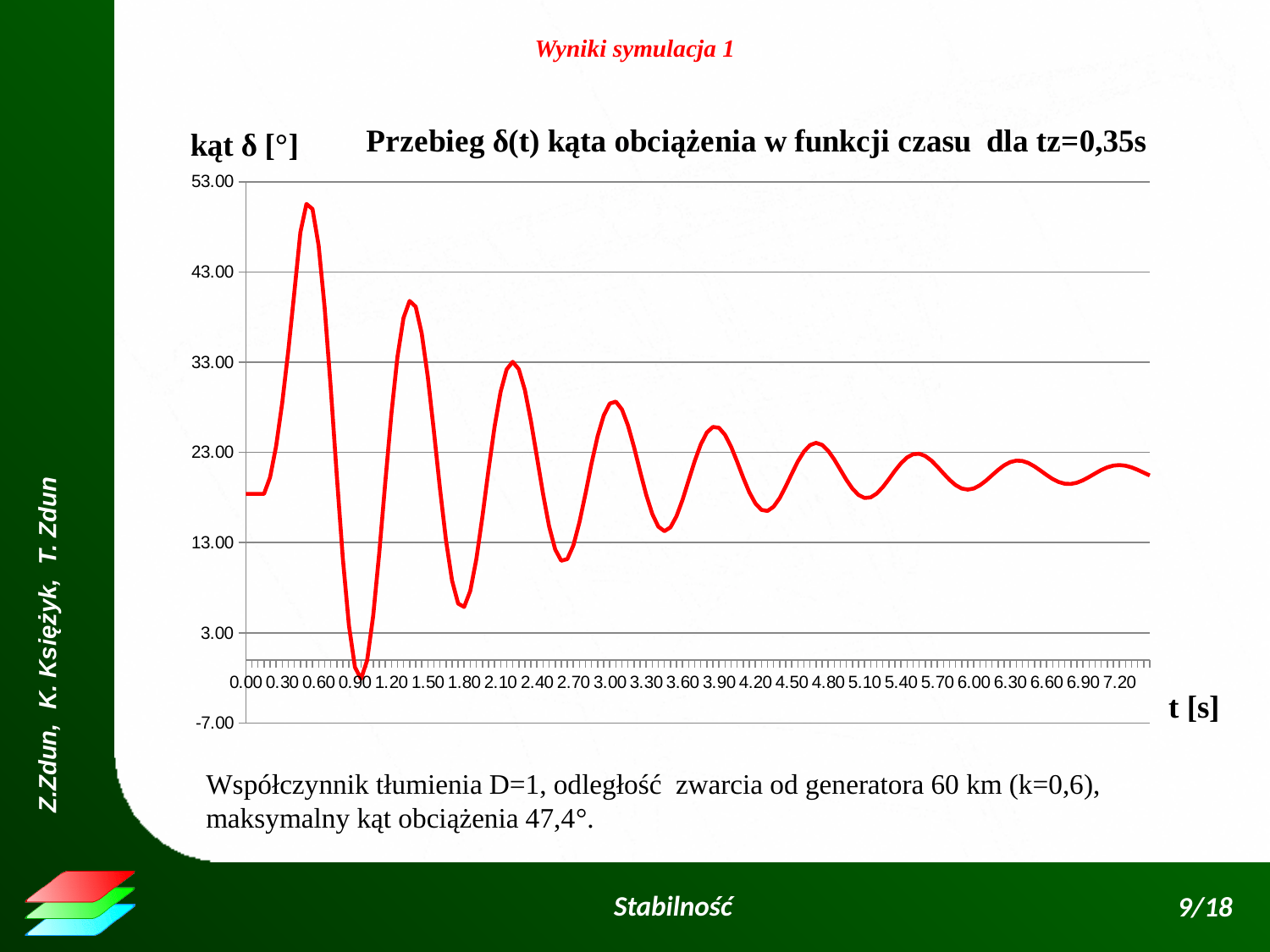
Is the second peak of the curve (near t=1.40) greater or less than 33.00? greater What is the highest value shown on the vertical axis of the chart? 53.00 What kind of chart is shown on the slide? line chart Does the amplitude of the oscillations increase or decrease as time increases along the x axis? decrease What label is shown on the horizontal axis of the chart? t [s] Is the lowest point of the curve (near t=0.90) greater or less than 3.00? less Is the value of δ at t=0.00 greater or less than 13.00? greater What is the title of the chart? Przebieg δ(t) kąta obciążenia w funkcji czasu dla tz=0,35s Which is larger: the first peak of the curve (near t=0.50) or the second peak (near t=1.40)? the first peak (near t=0.50)